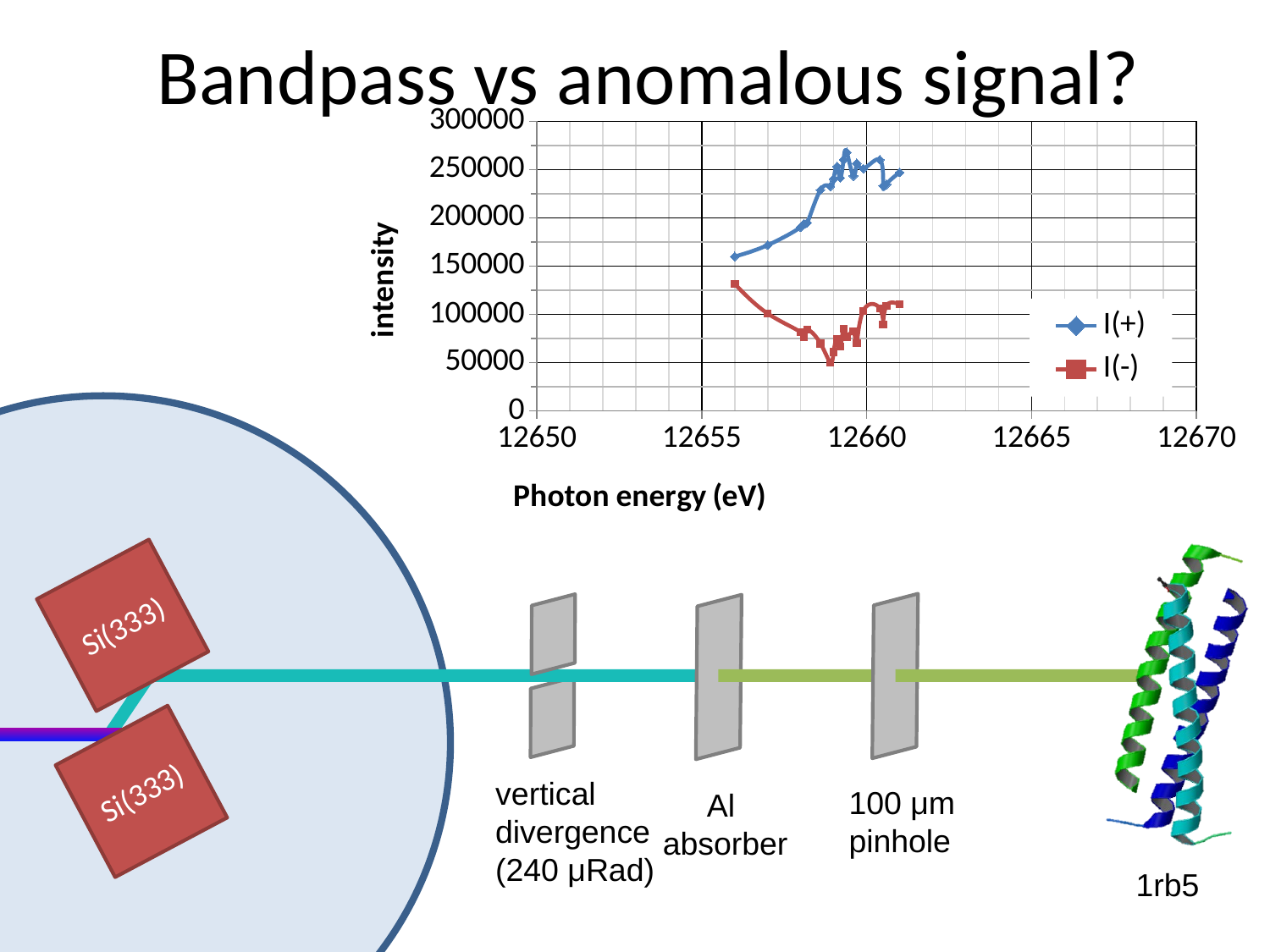
How many series does the chart legend list? 2 Which series has the lowest intensity value on the chart? I(-) Is the intensity of I(-) at 12656 eV greater or less than 100000? greater Is the intensity of I(+) at 12656 eV greater or less than 200000? less Is the lowest intensity of I(-) (near 12659 eV) greater or less than 100000? less Which series reaches the highest intensity on the chart? I(+) What are the two series named in the chart legend? I(+) and I(-) Which series has the higher intensity at a photon energy of 12656 eV, I(+) or I(-)? I(+) What kind of chart is shown on the slide? line chart Does the intensity of I(+) rise or fall as photon energy increases from 12656 eV to 12659 eV? rise What is the title of the x axis of the chart? Photon energy (eV)